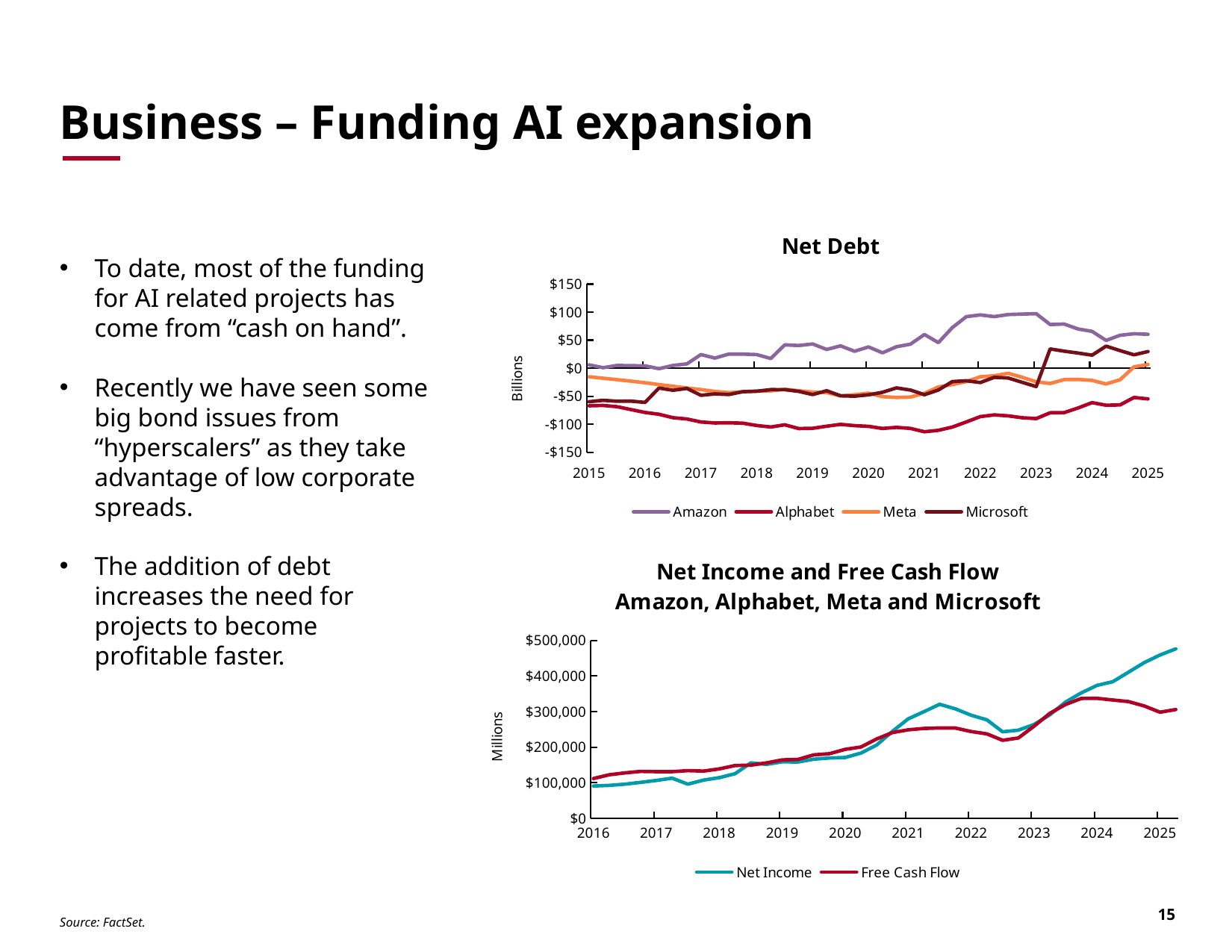
How many series does the legend of the Net Debt chart list? 4 In the Net Income and Free Cash Flow chart, which series is larger in 2025, Net Income or Free Cash Flow? Net Income In the Net Debt chart, is Amazon's net debt in 2022 greater or less than $50? greater In the Net Income and Free Cash Flow chart, is Net Income in 2025 greater or less than $400,000? greater In the Net Income and Free Cash Flow chart, does Net Income rise or fall from 2016 to 2025? rise How many series does the legend of the Net Income and Free Cash Flow chart list? 2 In the Net Debt chart, which company has the highest net debt in 2025? Amazon In the Net Debt chart, which company has the lowest net debt in 2021? Alphabet What kind of chart is the Net Debt chart? line chart In the Net Debt chart, in 2025 is Meta's net debt higher or lower than Alphabet's? higher In the Net Debt chart, is Alphabet's net debt in 2019 greater or less than -$50? less What unit is shown on the y-axis of the Net Debt chart? Billions